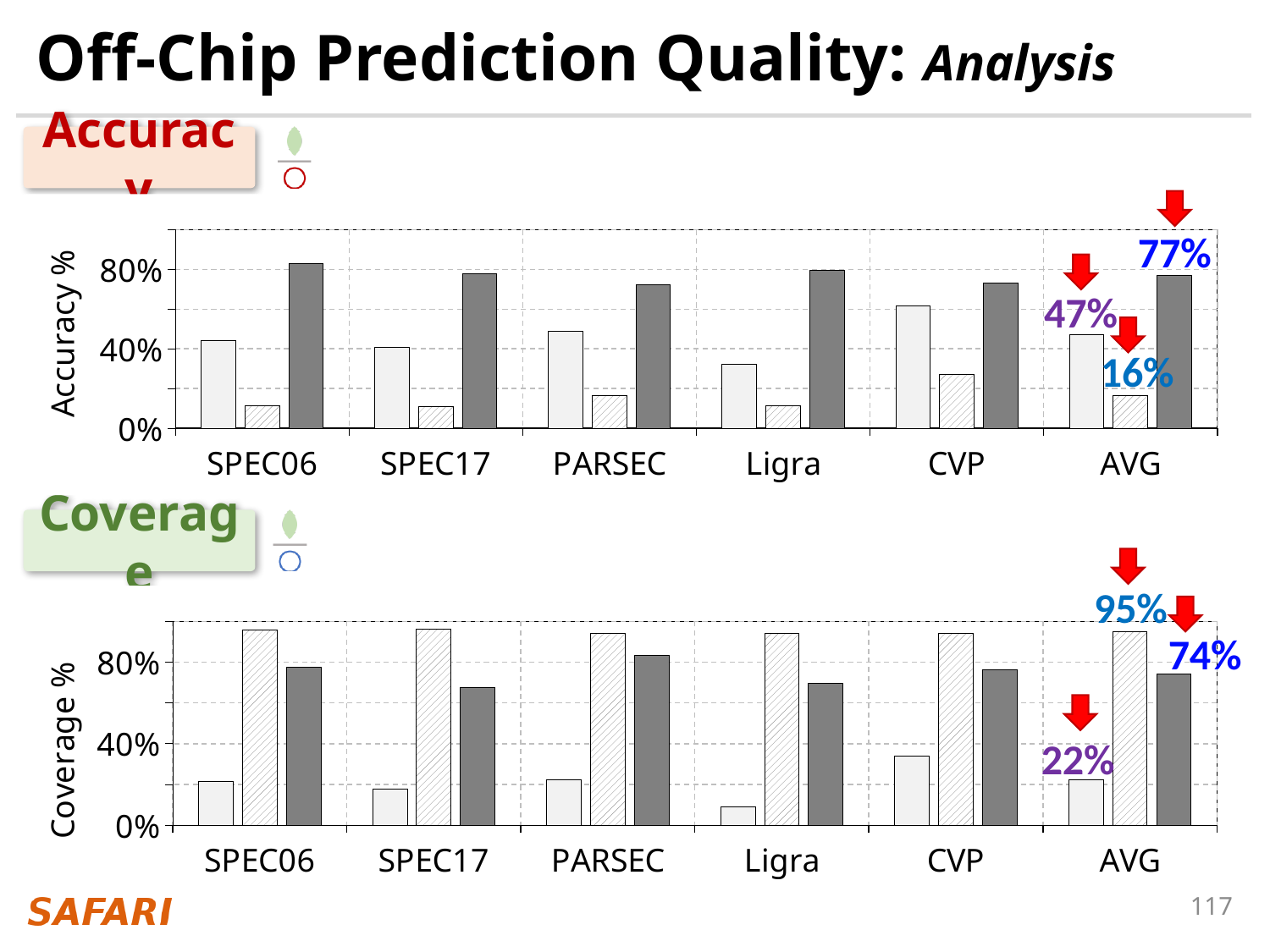
What kind of chart is the Accuracy chart? bar chart In the Accuracy chart, what is the labelled value of the hatched bar for AVG? 16% In the Accuracy chart, what is the labelled value of the light (first) bar for AVG? 47% In the Accuracy chart, what is the labelled value of the dark gray bar for AVG? 77% In the Coverage chart, what is the labelled value of the hatched bar for AVG? 95% In the Coverage chart, what is the difference between the hatched bar and the dark gray bar for AVG? 21% In the Coverage chart, is the light (first) bar for Ligra greater or less than 40%? less In the Coverage chart, what is the labelled value of the dark gray bar for AVG? 74% In the Coverage chart, what is the labelled value of the light (first) bar for AVG? 22% In the Accuracy chart, what is the difference between the dark gray bar and the light bar for AVG? 30% How many categories are shown on the x axis of the Coverage chart? 6 In the Accuracy chart, is the dark gray bar for SPEC06 greater or less than 80%? greater